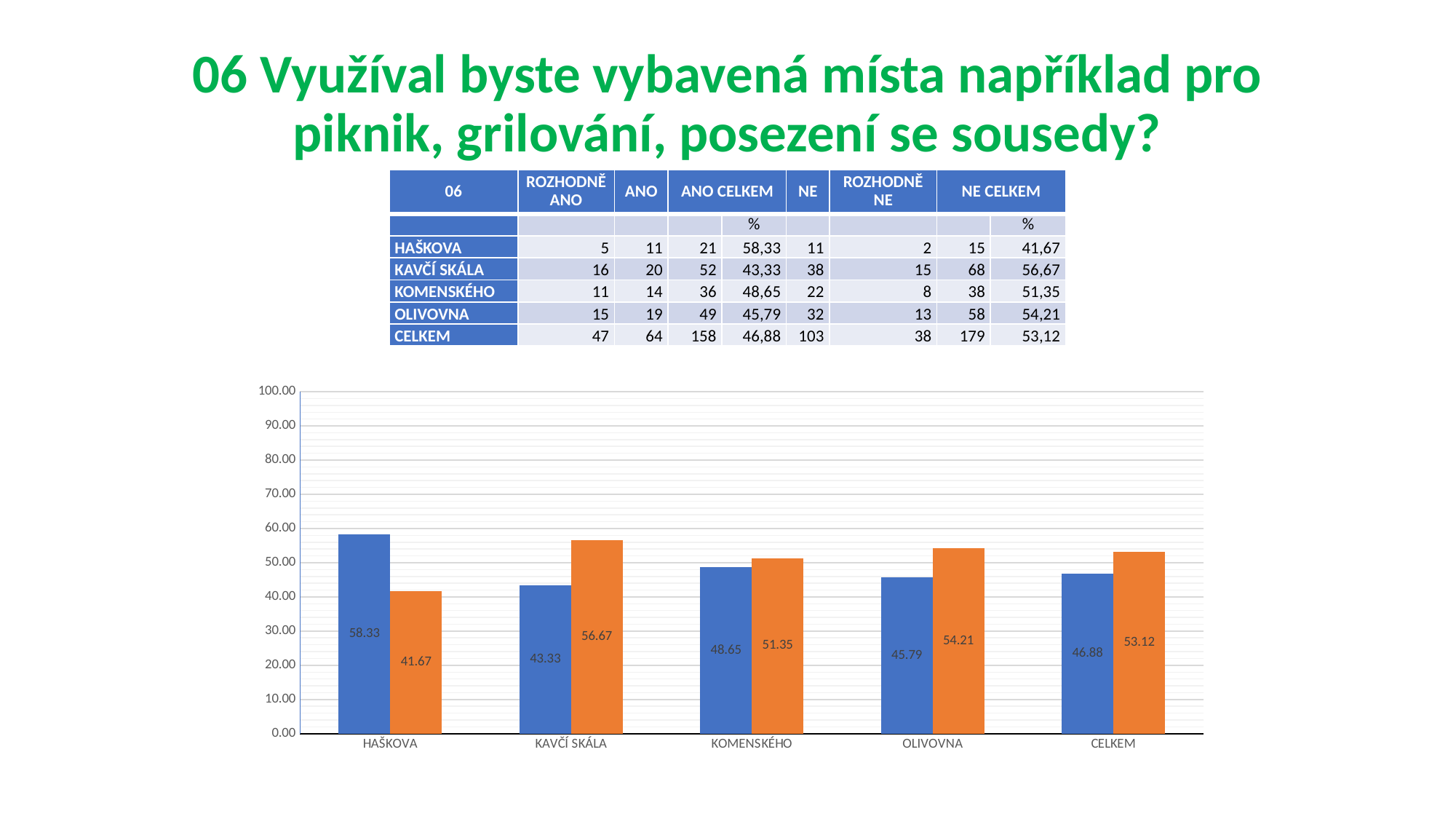
What is the value of the orange bar for OLIVOVNA? 54.21 What type of chart is shown on the slide? bar chart What is the difference between the orange bar and the blue bar for CELKEM? 6.24 What is the value of the blue bar for KOMENSKÉHO? 48.65 For OLIVOVNA, which bar is larger, the blue or the orange? orange Which category has the highest blue bar? HAŠKOVA Is the value of the blue bar for KAVČÍ SKÁLA greater or less than 50.00? less Which category has the lowest orange bar? HAŠKOVA How many categories are shown on the x axis of the chart? 5 What is the value of the blue bar for HAŠKOVA? 58.33 Which category has the lowest blue bar? KAVČÍ SKÁLA What is the value of the orange bar for KAVČÍ SKÁLA? 56.67